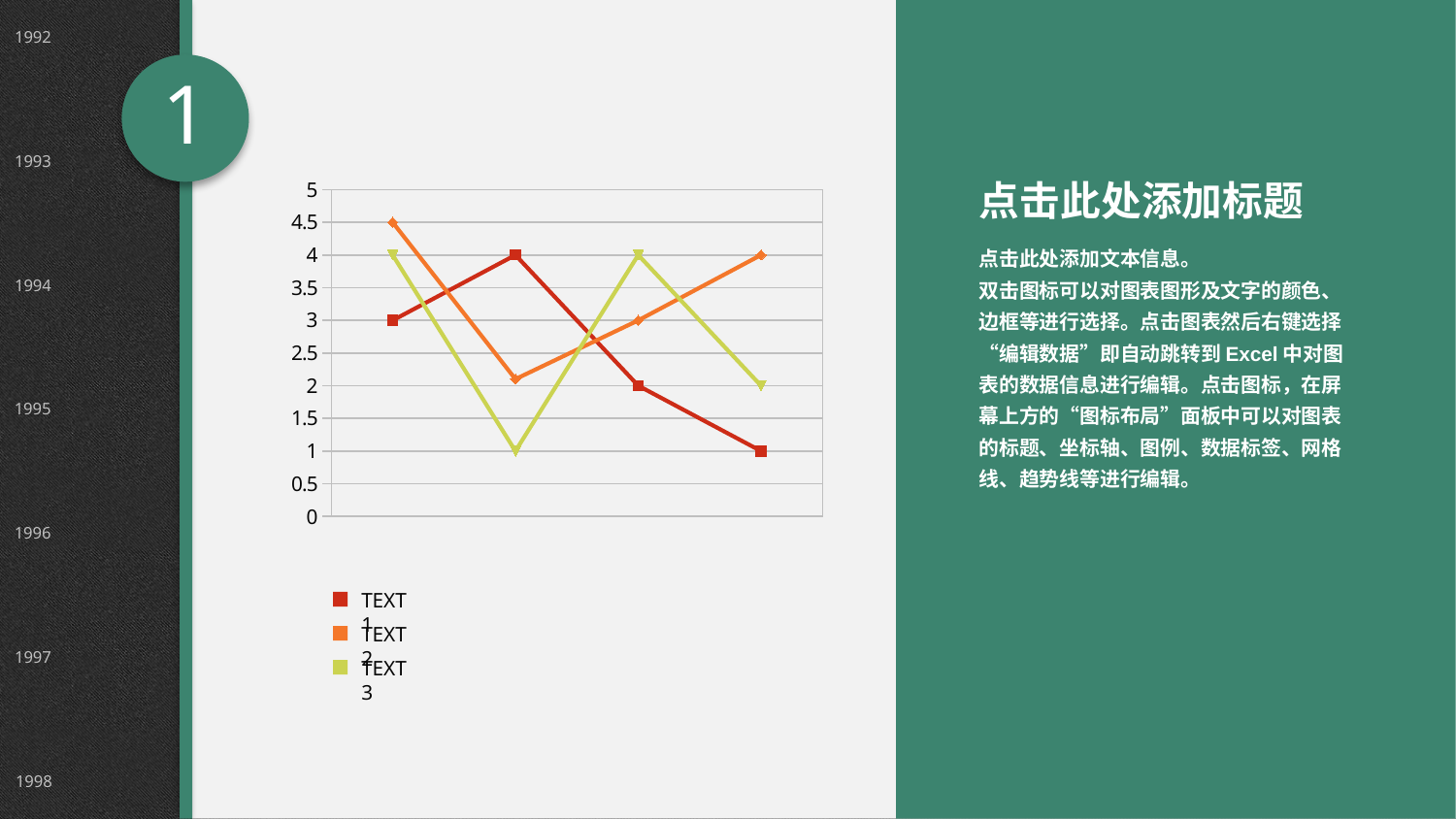
What is the value of the last point of the TEXT 1 series? 1 What is the value of the first point of the TEXT 2 series? 4.5 What is the value of the first point of the TEXT 1 series? 3 Which series has the highest value at the first point? TEXT 2 Is the value of the second point of the TEXT 2 series greater or less than 3? less How many data points does each line have? 4 Does the TEXT 1 line rise or fall from its second point to its fourth point? fall What kind of chart is shown on the slide? line chart What is the difference between the second point and the fourth point of the TEXT 1 series? 3 How many series does the legend list? 3 Which series has the lowest value at the last point? TEXT 1 What is the value of the second point of the TEXT 3 series? 1